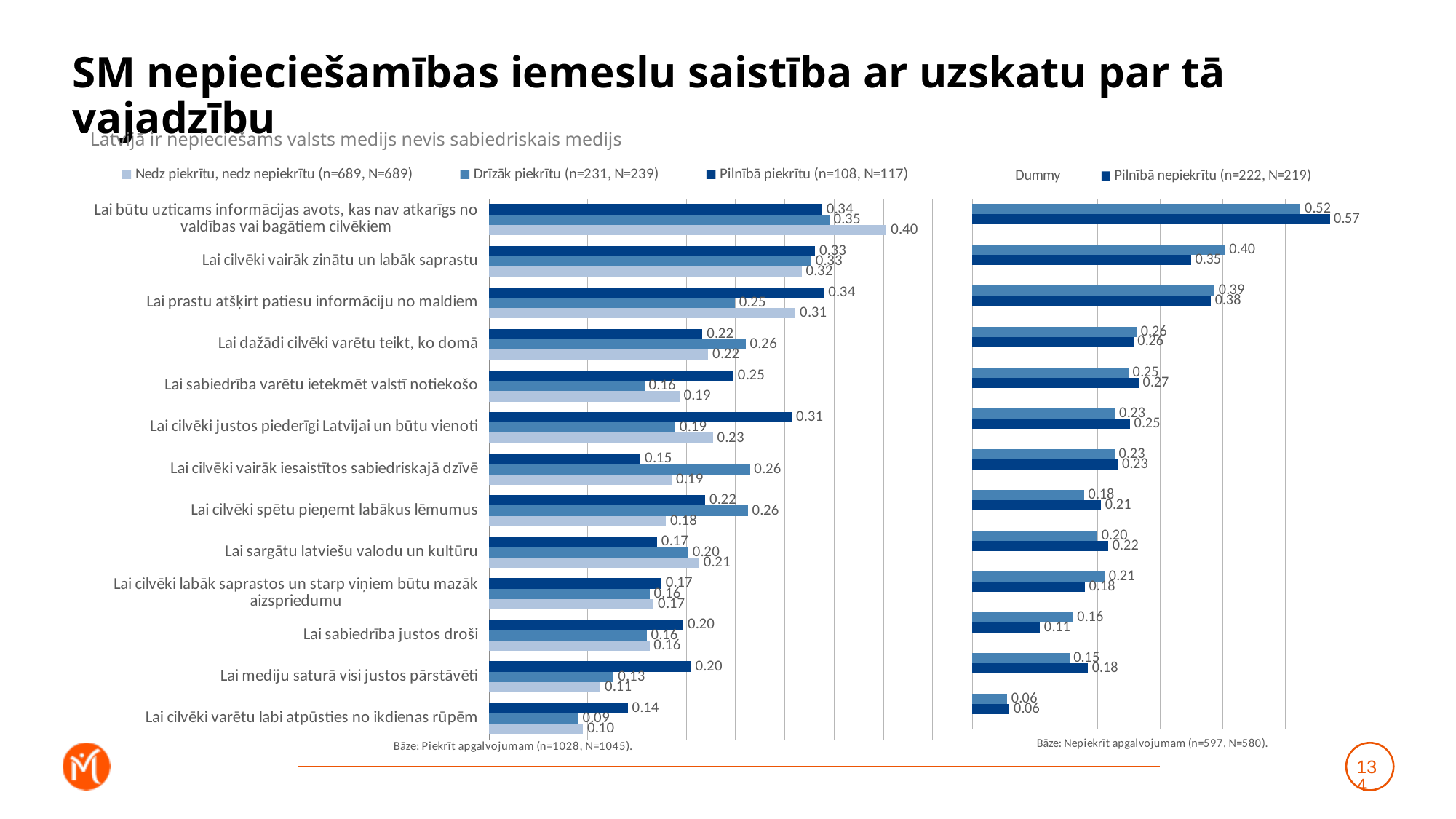
On the left chart, which category has the lowest value for the Pilnībā piekrītu series? Lai cilvēki varētu labi atpūsties no ikdienas rūpēm On the right chart, which category has the highest value for the Pilnībā nepiekrītu series? Lai būtu uzticams informācijas avots, kas nav atkarīgs no valdības vai bagātiem cilvēkiem On the left chart, what is the value of the Drīzāk piekrītu series for "Lai mediju saturā visi justos pārstāvēti"? 0.13 On the left chart, for "Lai cilvēki justos piederīgi Latvijai un būtu vienoti", which is larger: the Pilnībā piekrītu value or the Drīzāk piekrītu value? Pilnībā piekrītu On the right chart, what is the value of the Pilnībā nepiekrītu series for "Lai sabiedrība justos droši"? 0.11 On the left chart, what is the difference between the Drīzāk piekrītu and Pilnībā piekrītu values for "Lai cilvēki vairāk iesaistītos sabiedriskajā dzīvē"? 0.11 How many categories are shown on the left chart? 13 What type of chart is the left chart? Bar chart On the left chart, what is the value of the Pilnībā piekrītu series for "Lai prastu atšķirt patiesu informāciju no maldiem"? 0.34 On the right chart, what is the value of the Pilnībā nepiekrītu series for "Lai būtu uzticams informācijas avots, kas nav atkarīgs no valdības vai bagātiem cilvēkiem"? 0.57 On the left chart, what is the value of the Nedz piekrītu, nedz nepiekrītu series for "Lai būtu uzticams informācijas avots, kas nav atkarīgs no valdības vai bagātiem cilvēkiem"? 0.40 How many series does the legend of the left chart list? 3